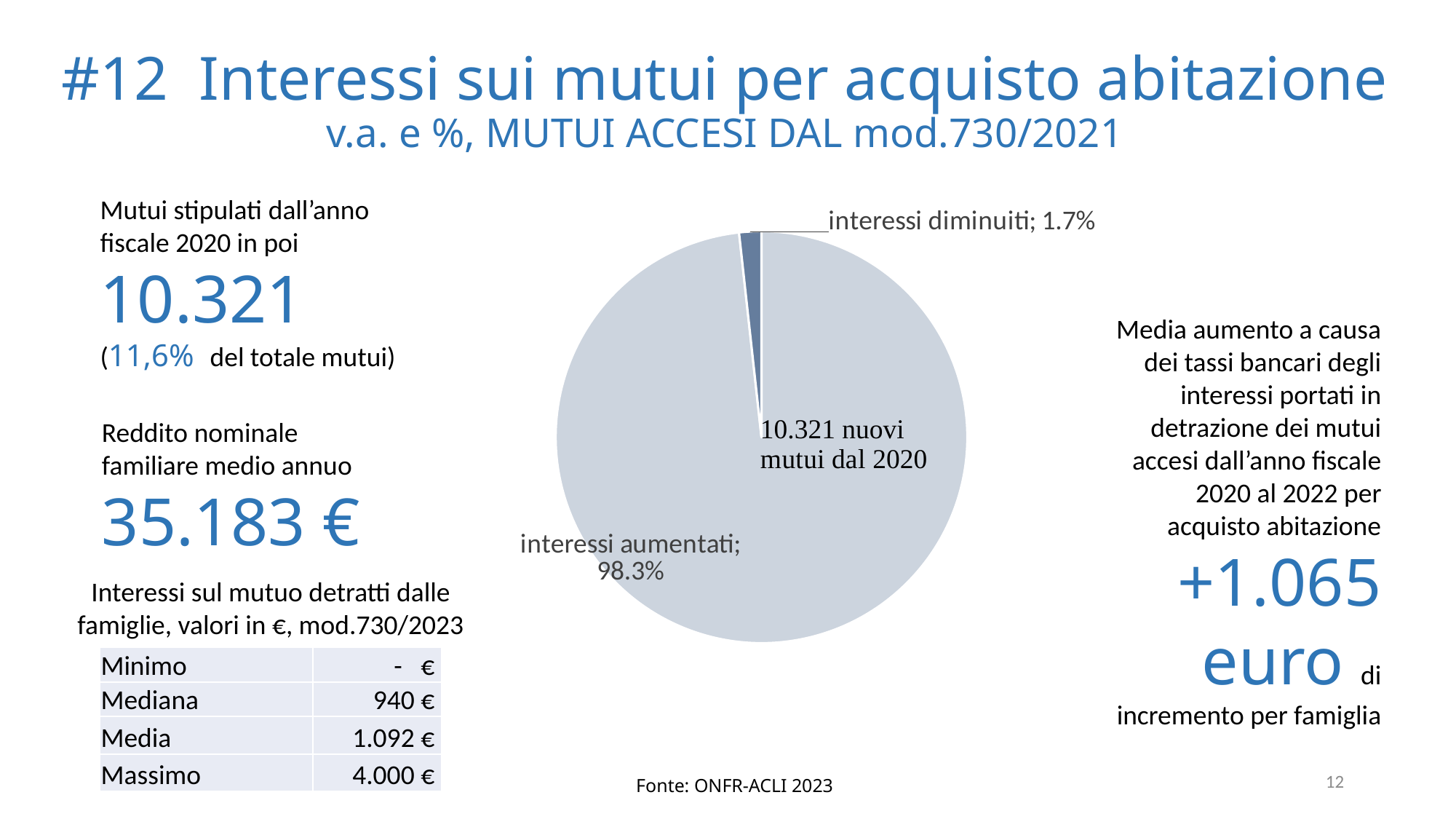
Which is larger in the pie chart, "interessi aumentati" or "interessi diminuiti"? interessi aumentati What is the difference in percentage points between the "interessi aumentati" and "interessi diminuiti" slices? 96.6 What is the source cited below the pie chart? Fonte: ONFR-ACLI 2023 What share of the pie is labelled "interessi aumentati"? 98.3% Which slice of the pie chart is the largest? interessi aumentati What text is written in the centre of the pie chart? 10.321 nuovi mutui dal 2020 Is the share for "interessi diminuiti" greater or less than 10%? less What kind of chart is shown on the slide? pie chart Which slice of the pie chart is the smallest? interessi diminuiti What share of the pie is labelled "interessi diminuiti"? 1.7% How many slices does the pie chart have? 2